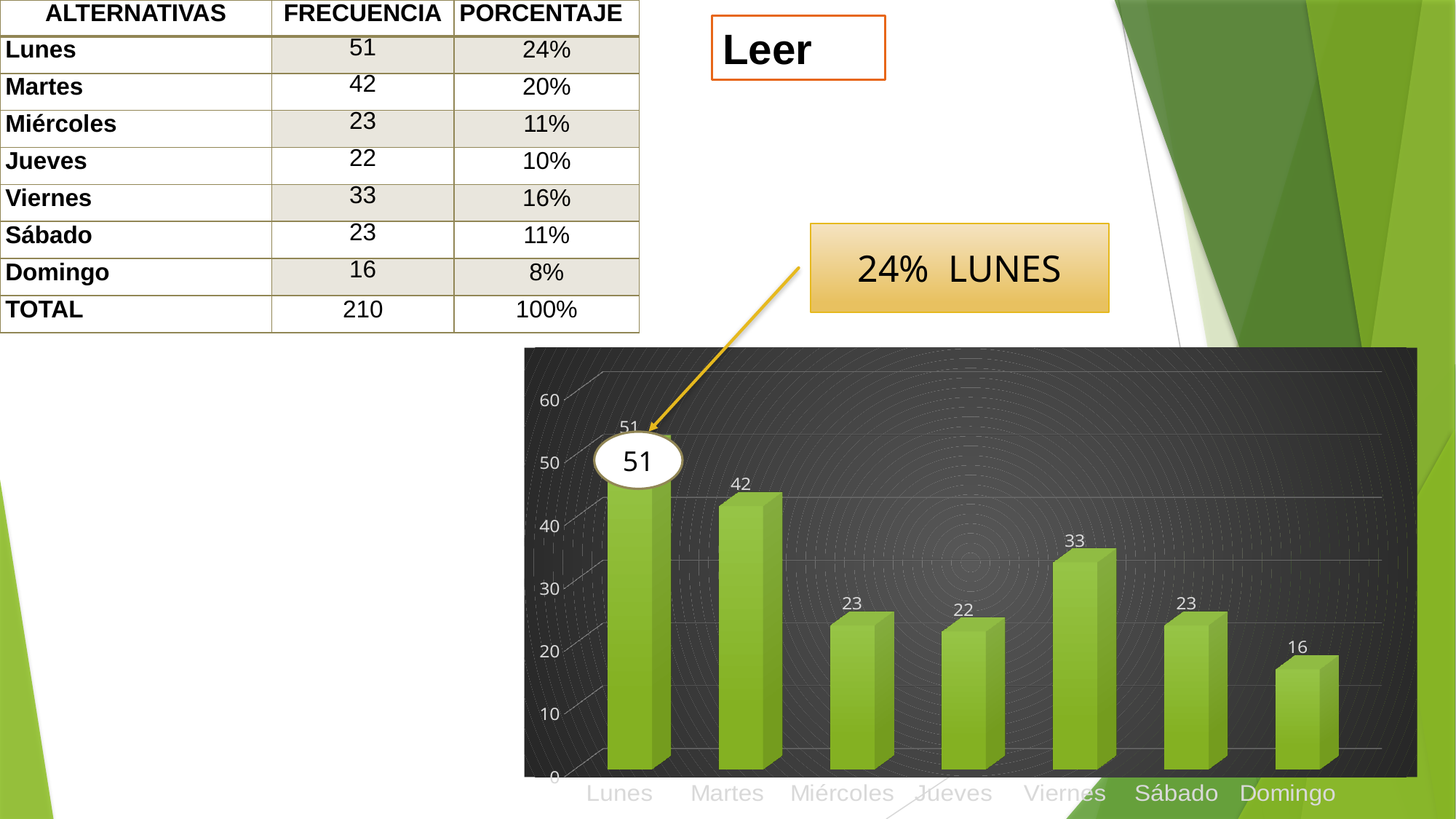
Is the value for Martes greater or less than 40? greater What is the difference between the values for Lunes and Martes? 9 Which day has the lowest value in the chart? Domingo How many days are shown on the x axis of the chart? 7 Which is larger, the value for Martes or the value for Viernes? Martes What is the value for Domingo in the chart? 16 What percentage does the callout box on the slide associate with Lunes? 24% What kind of chart is shown on the slide? bar chart Which day has the highest value in the chart? Lunes What is the difference between the values for Viernes and Domingo? 17 What is the value for Lunes in the chart? 51 What is the value for Viernes in the chart? 33